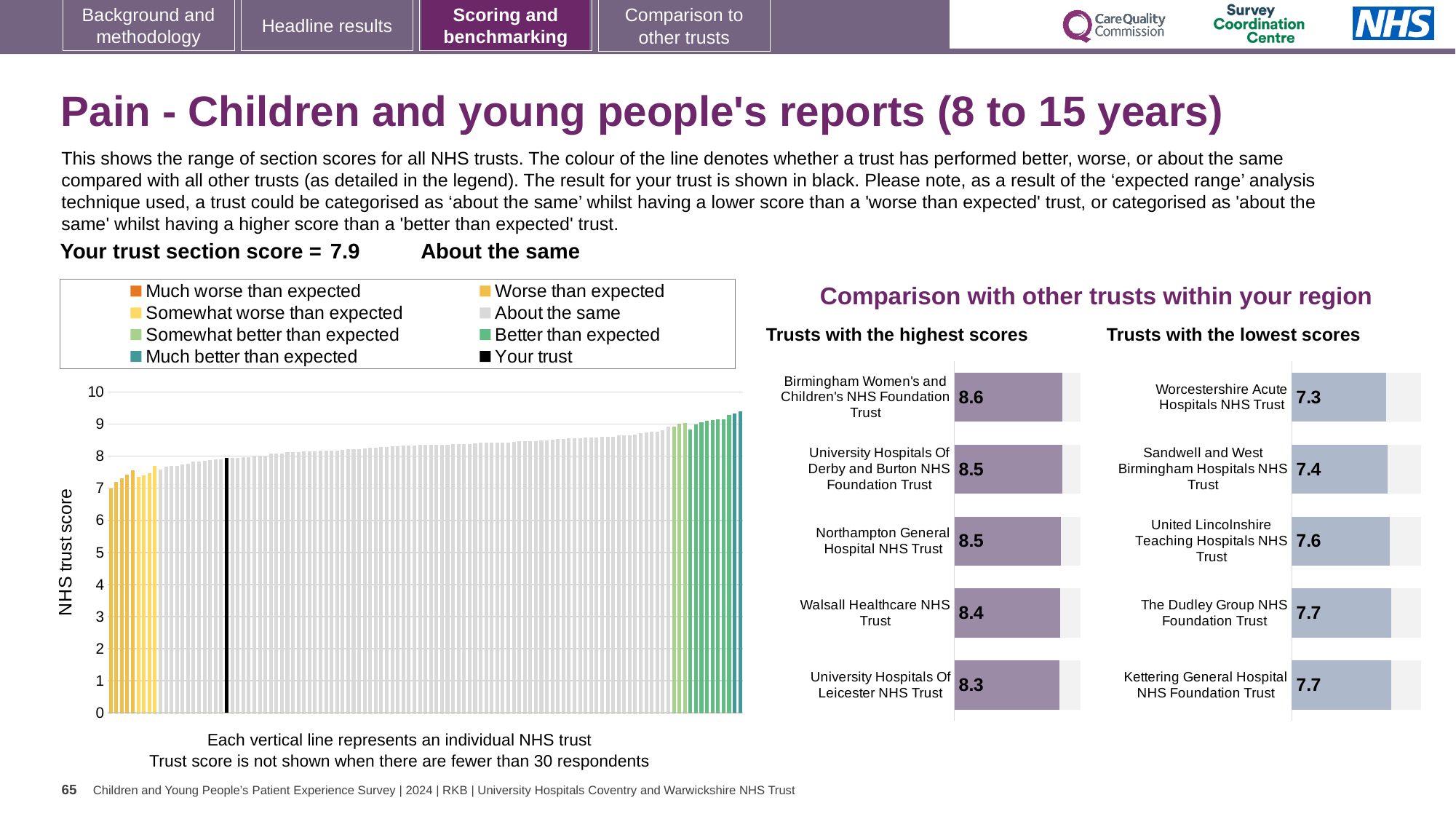
In the 'Trusts with the highest scores' chart, what is the difference between the scores of Birmingham Women's and Children's NHS Foundation Trust and University Hospitals Of Leicester NHS Trust? 0.3 In the 'Trusts with the highest scores' chart, which trust has the lowest score? University Hospitals Of Leicester NHS Trust In the 'Trusts with the highest scores' chart, what is the score for Birmingham Women's and Children's NHS Foundation Trust? 8.6 How many entries does the legend of the NHS trust score chart list? 8 In the 'Trusts with the lowest scores' chart, how many trusts are shown? 5 In the NHS trust score chart on the left, do the bar heights rise or fall from left to right? Rise In the 'Trusts with the lowest scores' chart, which trust has the lowest score? Worcestershire Acute Hospitals NHS Trust What kind of chart is the NHS trust score chart on the left? Bar chart In the 'Trusts with the highest scores' chart, which has the larger score: Walsall Healthcare NHS Trust or University Hospitals Of Leicester NHS Trust? Walsall Healthcare NHS Trust In the 'Trusts with the lowest scores' chart, what is the difference between the scores of Kettering General Hospital NHS Foundation Trust and Worcestershire Acute Hospitals NHS Trust? 0.4 In the NHS trust score chart on the left, what is the highest value shown on the y axis? 10 In the 'Trusts with the lowest scores' chart, what is the score for Worcestershire Acute Hospitals NHS Trust? 7.3